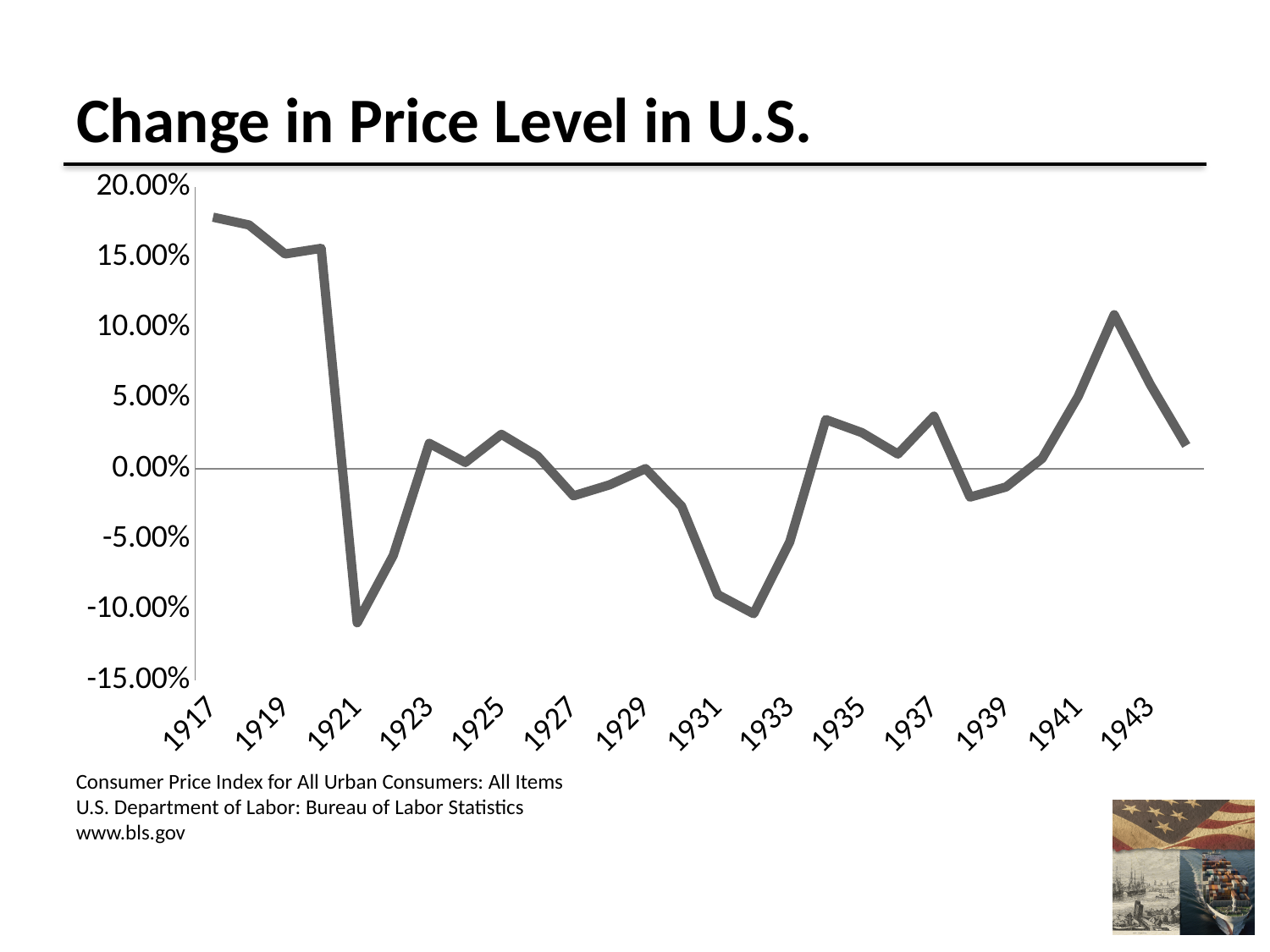
Is the value for 1917 greater or less than 15.00%? greater Which is larger, the value for 1917 or the value for 1943? 1917 Which labeled year on the x axis has the lowest value? 1921 What kind of chart is shown on the slide? line chart Is the value for 1935 greater or less than 0.00%? greater What is the title of the chart? Change in Price Level in U.S. Do the values rise or fall from 1917 to 1921? fall Is the value for 1921 greater or less than -10.00%? less Which labeled year on the x axis has the highest value? 1917 Which is larger, the value for 1941 or the value for 1939? 1941